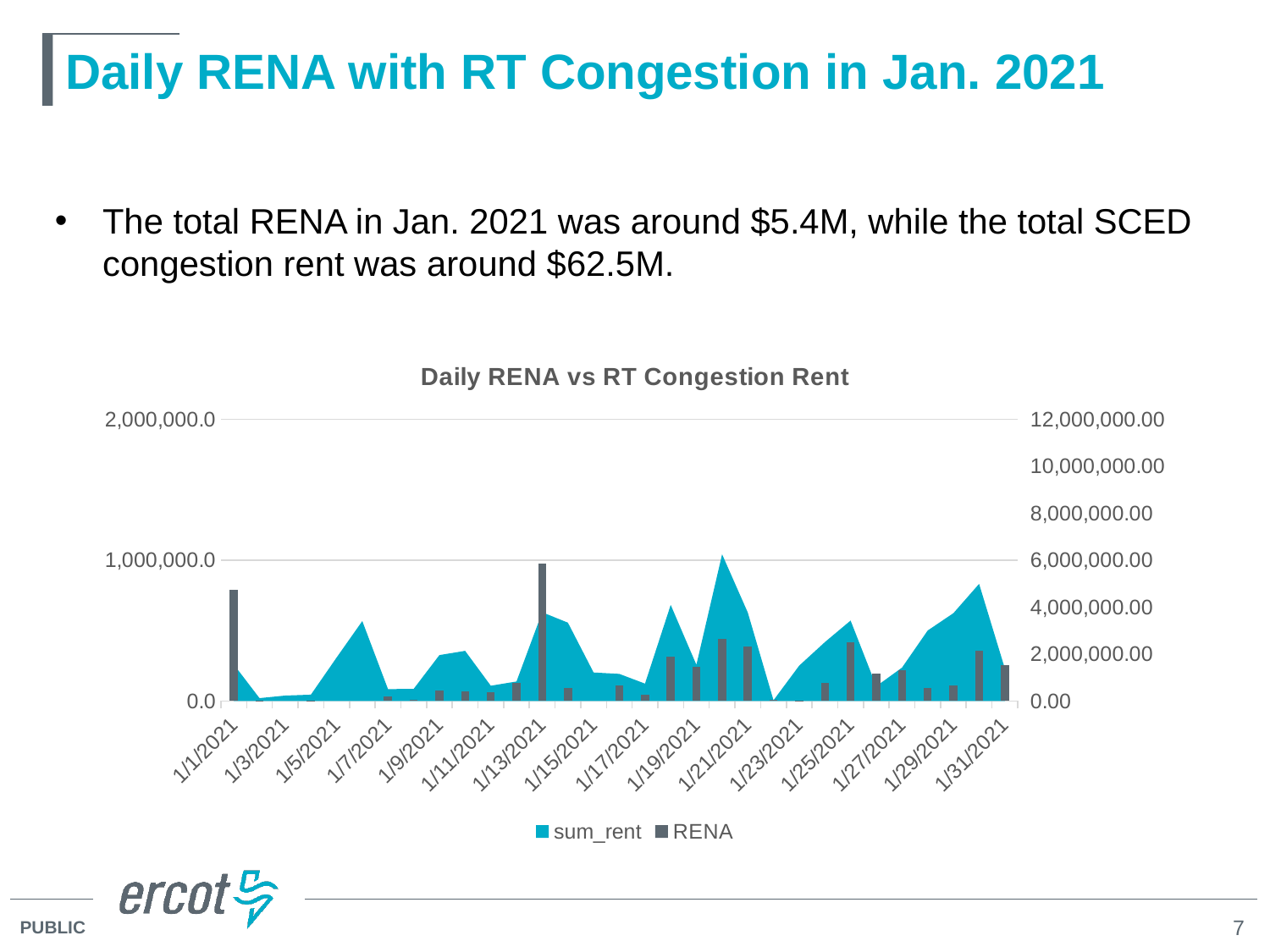
Is the sum_rent value on 1/21/2021 greater or less than 8,000,000.00 on the right axis? less Which date has the larger sum_rent value, 1/21/2021 or 1/1/2021? 1/21/2021 Which series is drawn as bars in the chart? RENA On which date does the RENA series reach its highest value? 1/13/2021 How many date labels are shown along the x axis of the chart? 16 Is the RENA value on 1/1/2021 greater or less than 1,000,000.0 on the left axis? less How many series does the chart's legend list? 2 What is the title of the chart on the slide? Daily RENA vs RT Congestion Rent What kind of chart is shown on the slide? Combined area and bar chart Which date has the larger RENA value, 1/1/2021 or 1/3/2021? 1/1/2021 On which date does the sum_rent series reach its highest value? 1/20/2021